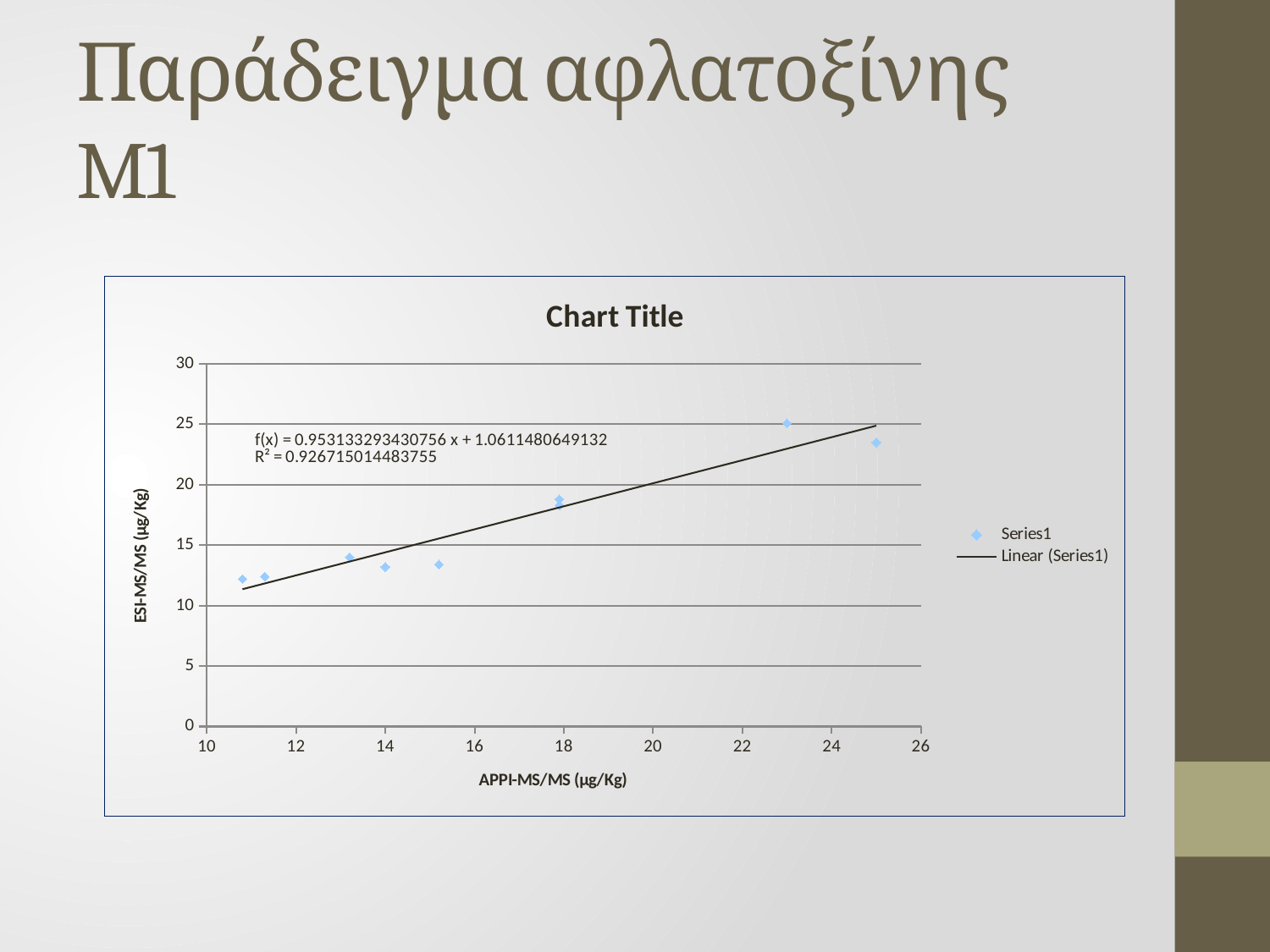
What is the R² value shown on the chart? 0.926715014483755 How many series does the legend list? 2 What kind of chart is shown on the slide? scatter chart Is the ESI-MS/MS value for the point at APPI-MS/MS of about 18 greater or less than 15? greater Is the ESI-MS/MS value for the point at APPI-MS/MS of about 23 greater or less than 20? greater What is the label of the x axis? APPI-MS/MS (μg/Kg) What is the title of the chart? Chart Title Which point has a higher ESI-MS/MS value: the one at APPI-MS/MS of about 14 or the one at about 18? the one at about 18 What is the trendline equation shown on the chart? f(x) = 0.953133293430756 x + 1.0611480649132 Do the ESI-MS/MS values generally rise or fall as APPI-MS/MS increases? rise Is the ESI-MS/MS value for the point at APPI-MS/MS of about 11 greater or less than 15? less Which point has the highest ESI-MS/MS value: the one at APPI-MS/MS of about 23 or the one at about 25? the one at about 23